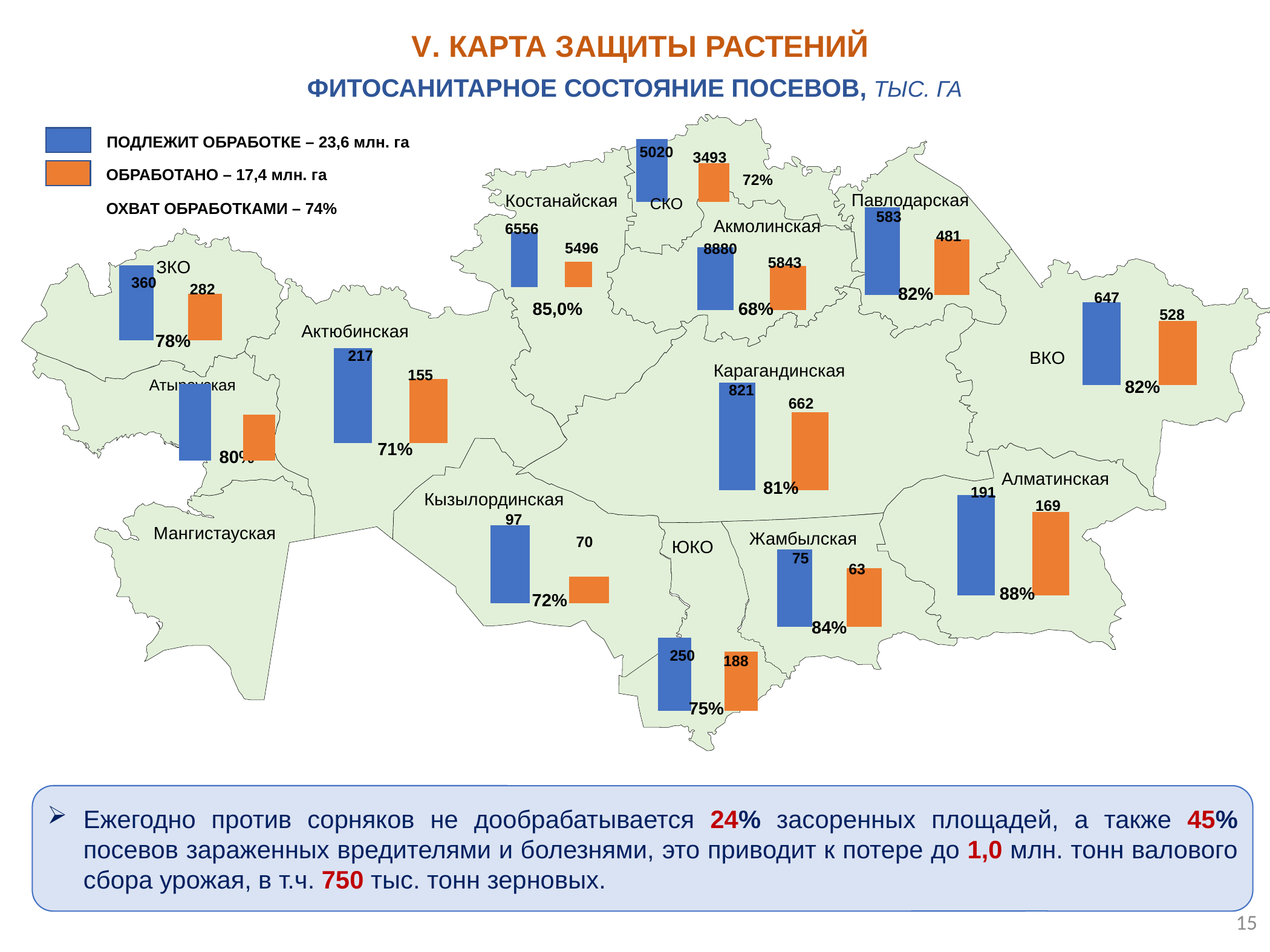
Which is larger: the подлежит обработке value for Костанайская or for СКО? Костанайская On the Акмолинская chart, what is the value of the orange bar (обработано)? 5843 On the Костанайская chart, what is the value of the blue bar (подлежит обработке)? 6556 What kind of chart is used for each region on the map? Bar chart Which region's chart shows the lowest coverage percentage (охват обработками)? Акмолинская Which region's chart shows the highest coverage percentage (охват обработками)? Алматинская Which region's chart shows the highest value for подлежит обработке? Акмолинская How many series does the legend list for the regional charts? 2 On the Акмолинская chart, what is the difference between the blue bar (8880) and the orange bar (5843)? 3037 On the ЗКО chart, what is the difference between подлежит обработке and обработано? 78 On the СКО chart, what coverage percentage (охват обработками) is shown? 72% On the Алматинская chart, what is the value of the blue bar (подлежит обработке)? 191